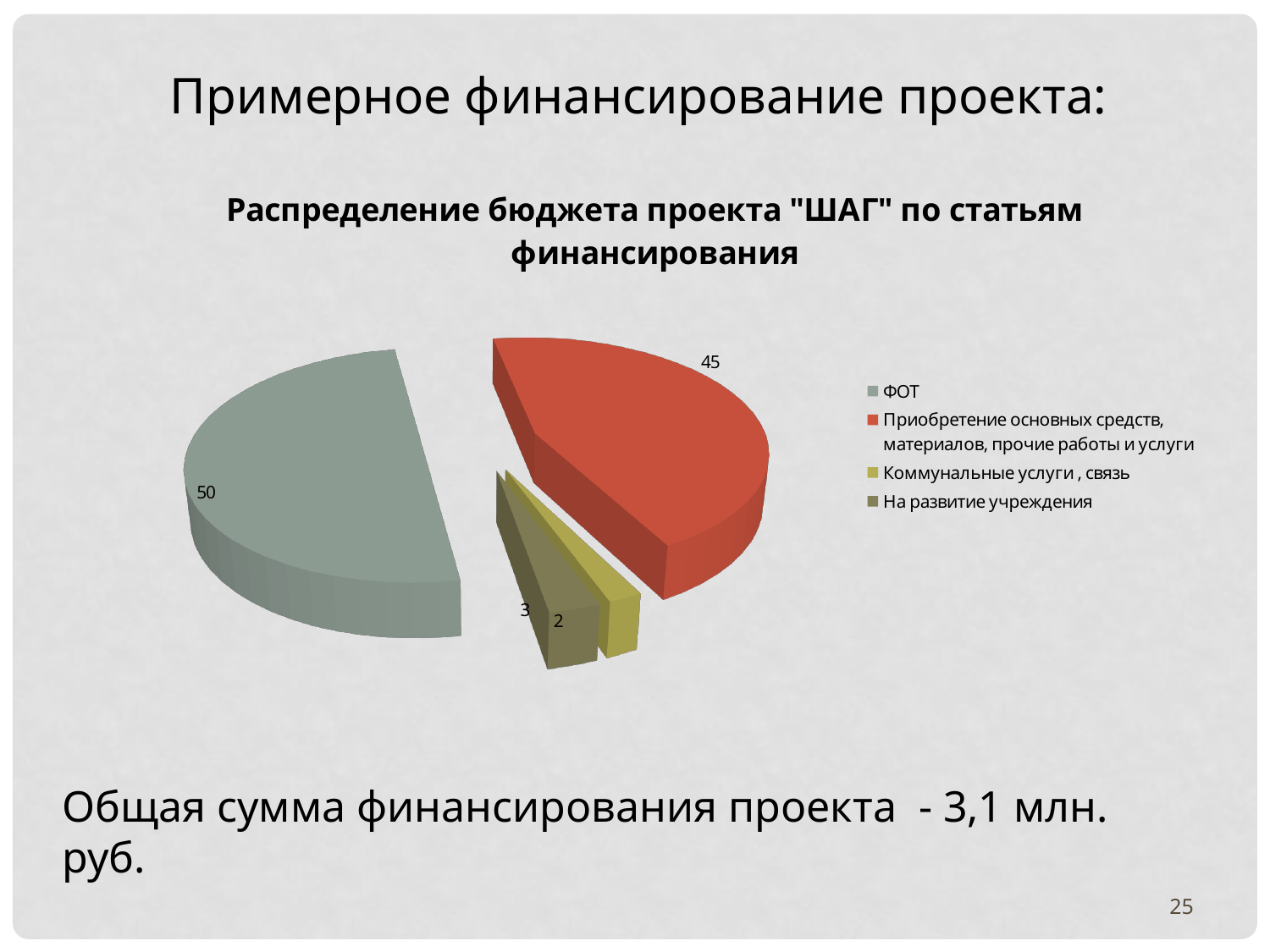
What is the value for Коммунальные услуги, связь? 2 What is the title of the chart? Распределение бюджета проекта "ШАГ" по статьям финансирования Which is larger: the value for На развитие учреждения or the value for Коммунальные услуги, связь? На развитие учреждения What is the value for Приобретение основных средств, материалов, прочие работы и услуги? 45 What colour is the slice for ФОТ? Grey What is the value for На развитие учреждения? 3 What is the value for ФОТ? 50 How many slices does the pie chart have? 4 What is the difference between the values for ФОТ and Приобретение основных средств, материалов, прочие работы и услуги? 5 What type of chart is shown on the slide? Pie chart Which category has the largest slice of the pie? ФОТ Which category has the smallest slice of the pie? Коммунальные услуги, связь